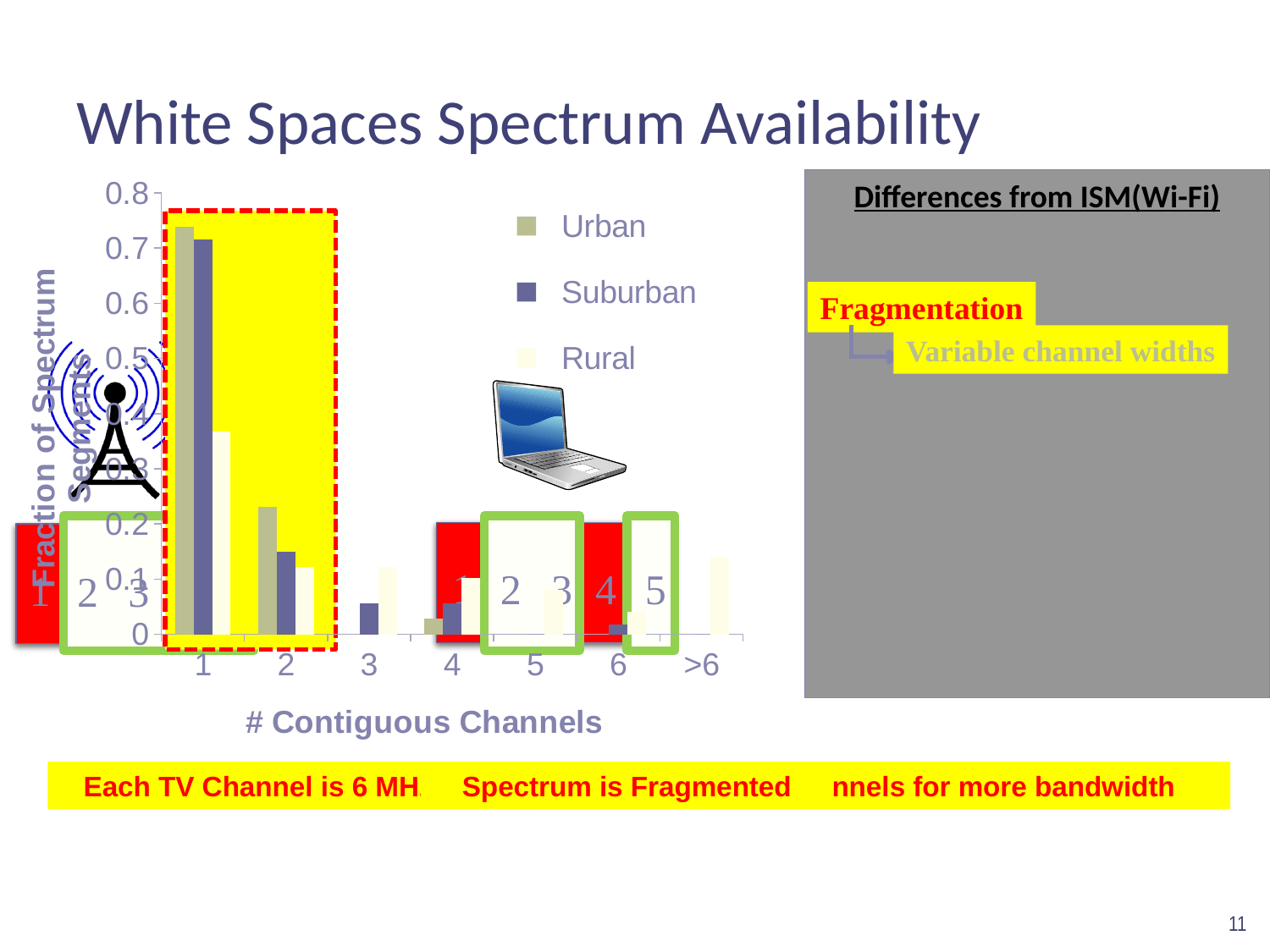
For which number of contiguous channels is the Rural value highest? 1 For 1 contiguous channel, which is larger: the Urban value or the Rural value? Urban How many series does the chart's legend list? 3 What kind of chart is shown on the slide? bar chart How many categories are shown on the x axis of the chart? 7 For which number of contiguous channels is the Urban value highest? 1 Is the Urban value for 1 contiguous channel greater or less than 0.7? greater Is the Rural value for 1 contiguous channel greater or less than 0.5? less Is the Suburban value for 1 contiguous channel greater or less than 0.6? greater Do the Urban values rise or fall as the number of contiguous channels increases from 1 to 3? fall What is the title of the x axis of the chart? # Contiguous Channels